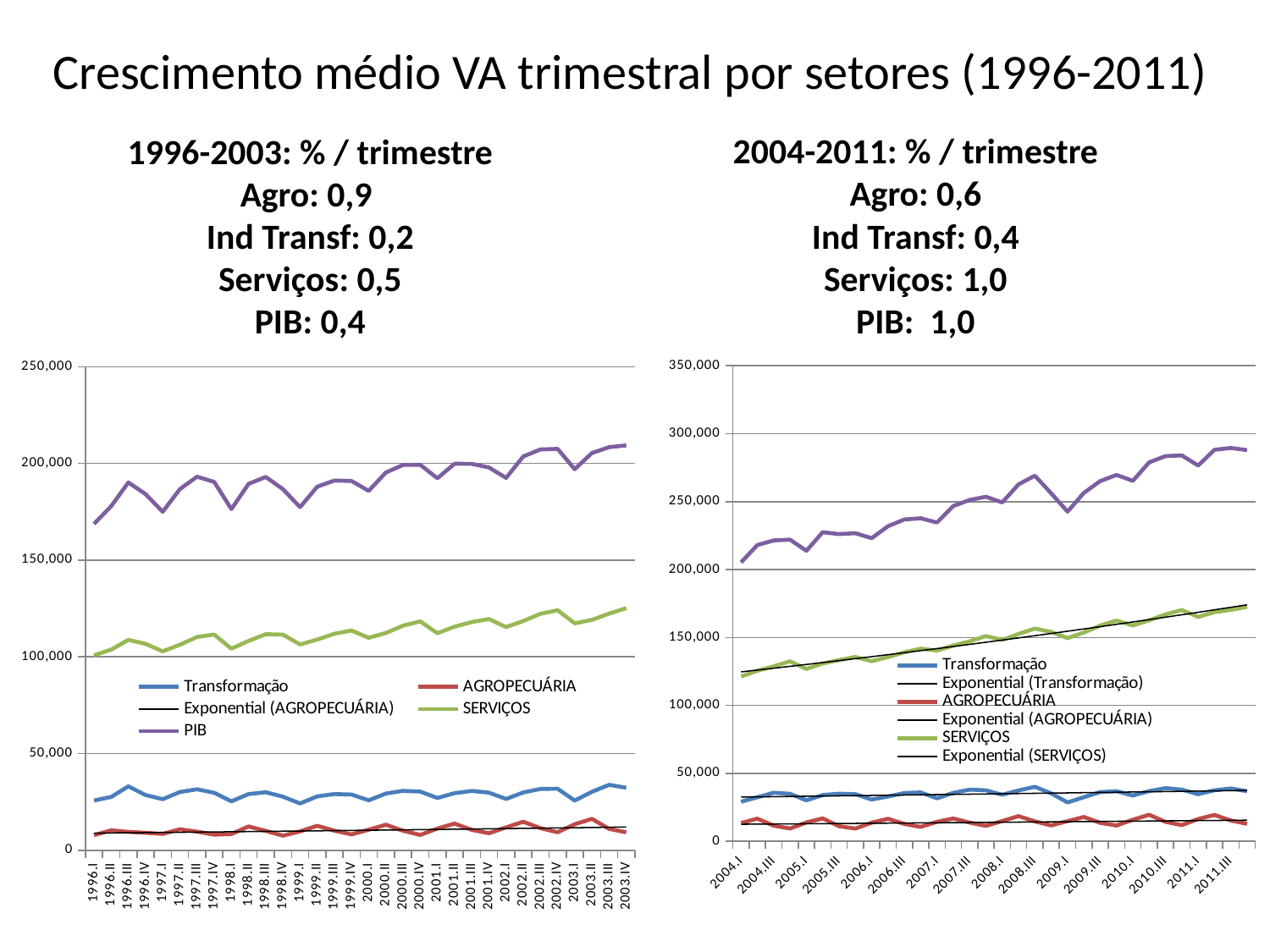
How many series does the legend of the left chart (1996-2003) list? 5 In the right chart (2004-2011), is the value of the purple PIB line at 2011.III greater or less than 250,000? greater How many series does the legend of the right chart (2004-2011) list? 6 What kind of chart is the left chart (1996-2003)? line chart In the right chart (2004-2011), does the SERVIÇOS line generally rise or fall from 2004.I to 2011.III? rise In the left chart (1996-2003), which series is higher throughout: PIB or SERVIÇOS? PIB What is the highest value shown on the y axis of the right chart (2004-2011)? 350,000 In the left chart (1996-2003), is the value of SERVIÇOS at 2003.IV greater or less than 100,000? greater In the right chart (2004-2011), is the value of SERVIÇOS at 2004.I greater or less than 150,000? less How many quarter labels are shown on the x axis of the left chart (1996-2003)? 32 In the right chart (2004-2011), which series is higher throughout: Transformação or AGROPECUÁRIA? Transformação